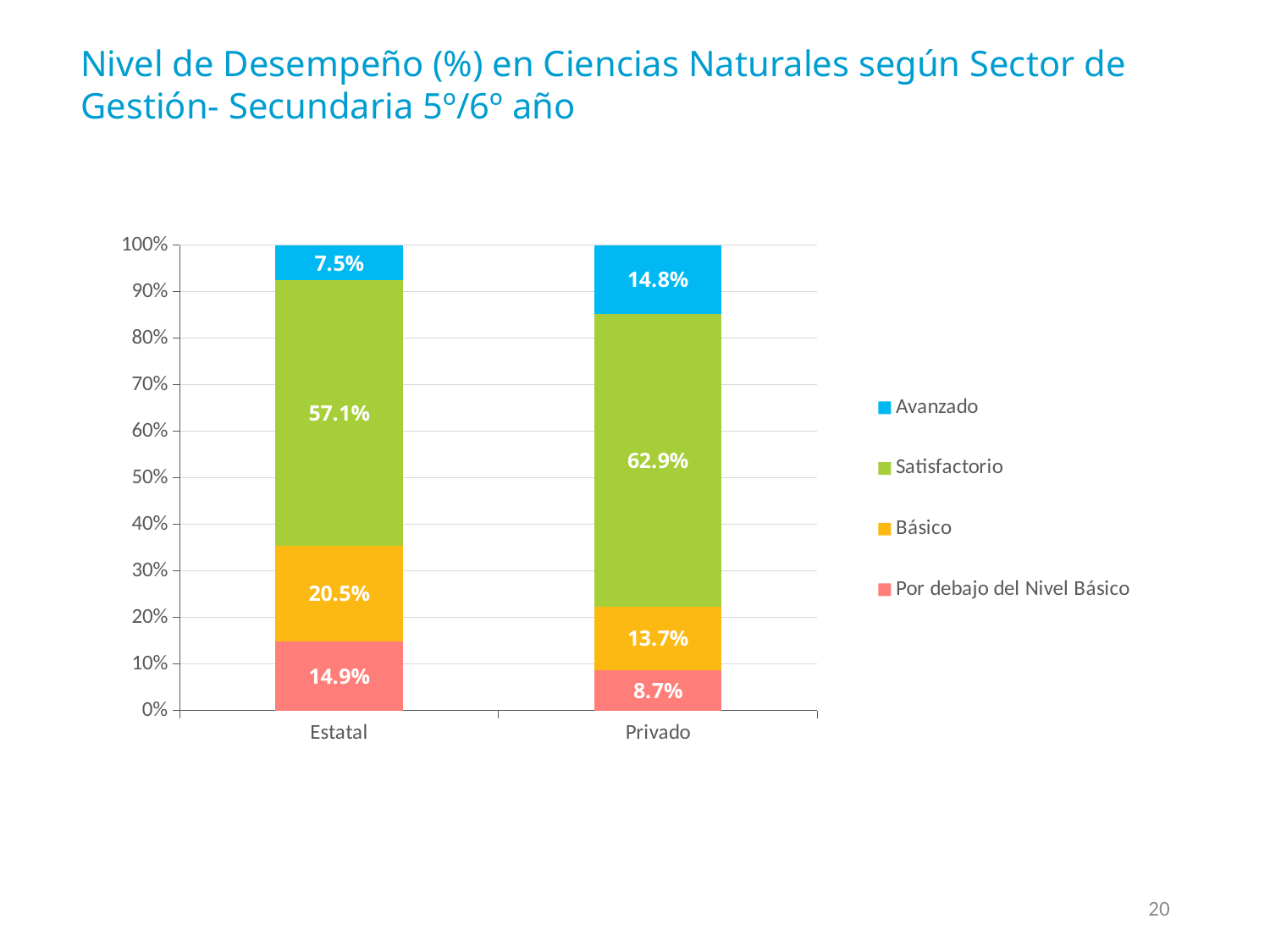
What is the difference between the Avanzado values for Privado and Estatal? 7.3 percentage points What is the Básico value for Estatal? 20.5% Which performance level has the largest share in the Estatal bar? Satisfactorio What is the Avanzado value for Privado? 14.8% What is the Satisfactorio value for Estatal? 57.1% Which sector has the higher Avanzado value? Privado How many series does the legend list? 4 What is the Por debajo del Nivel Básico value for Privado? 8.7% What is the difference between the Satisfactorio values for Privado and Estatal? 5.8 percentage points Which sector has the higher Por debajo del Nivel Básico value? Estatal What type of chart is shown on the slide? Stacked bar chart Which performance level has the smallest share in the Privado bar? Por debajo del Nivel Básico